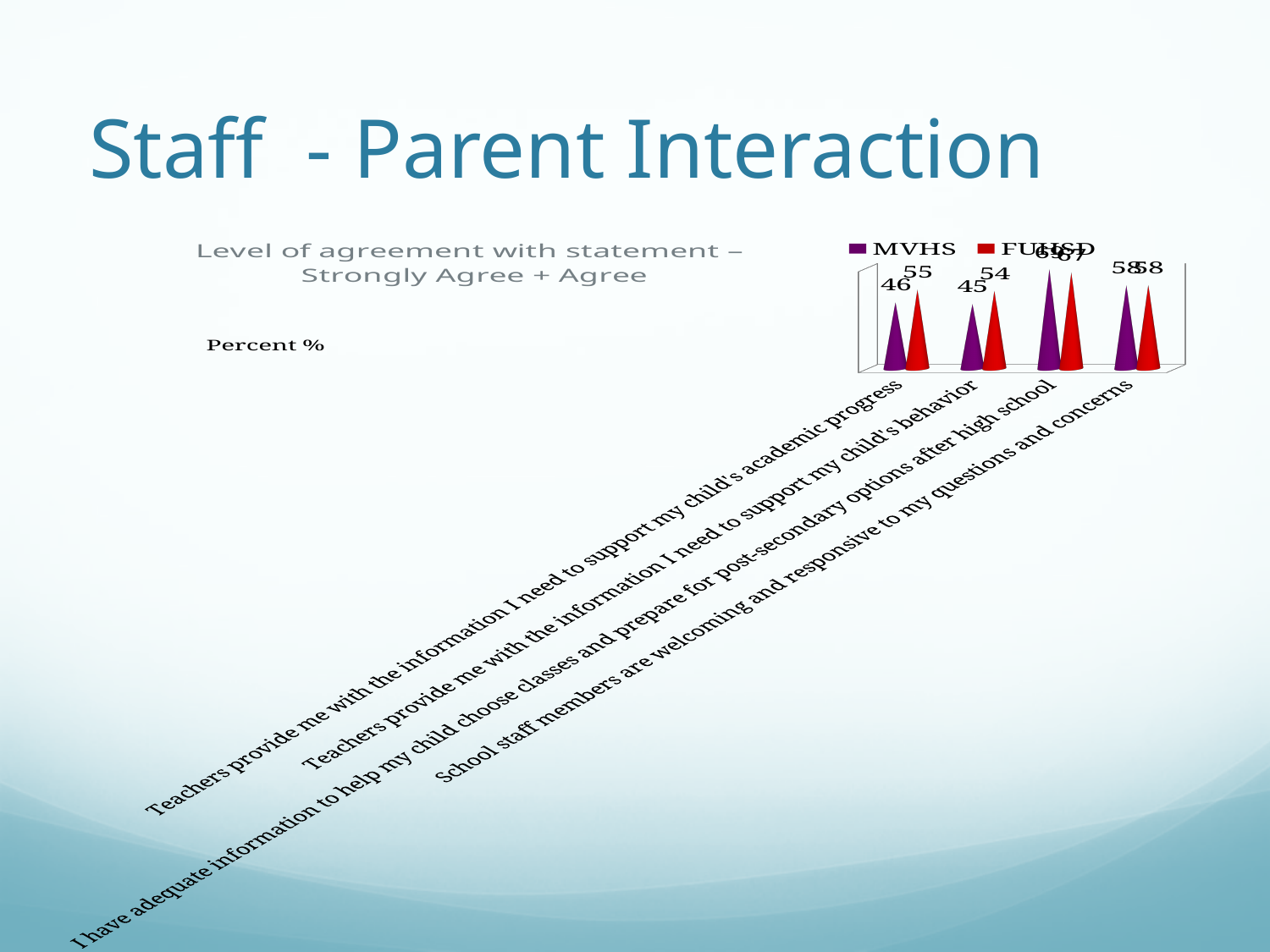
For "Teachers provide me with the information I need to support my child's academic progress", which series has the larger value, MVHS or FUHSD? FUHSD What is the FUHSD value for "Teachers provide me with the information I need to support my child's academic progress"? 55 What is the MVHS value for "Teachers provide me with the information I need to support my child's academic progress"? 46 What are the two series named in the legend? MVHS and FUHSD How many series does the legend list? 2 What is the difference between the FUHSD and MVHS values for "Teachers provide me with the information I need to support my child's behavior"? 9 What is the MVHS value for "Teachers provide me with the information I need to support my child's behavior"? 45 What is the FUHSD value for "Teachers provide me with the information I need to support my child's behavior"? 54 What is the MVHS value for "School staff members are welcoming and responsive to my questions and concerns"? 58 What is the difference between the FUHSD and MVHS values for "Teachers provide me with the information I need to support my child's academic progress"? 9 What kind of chart is shown on the slide? Bar chart How many statement categories are plotted on the chart? 4